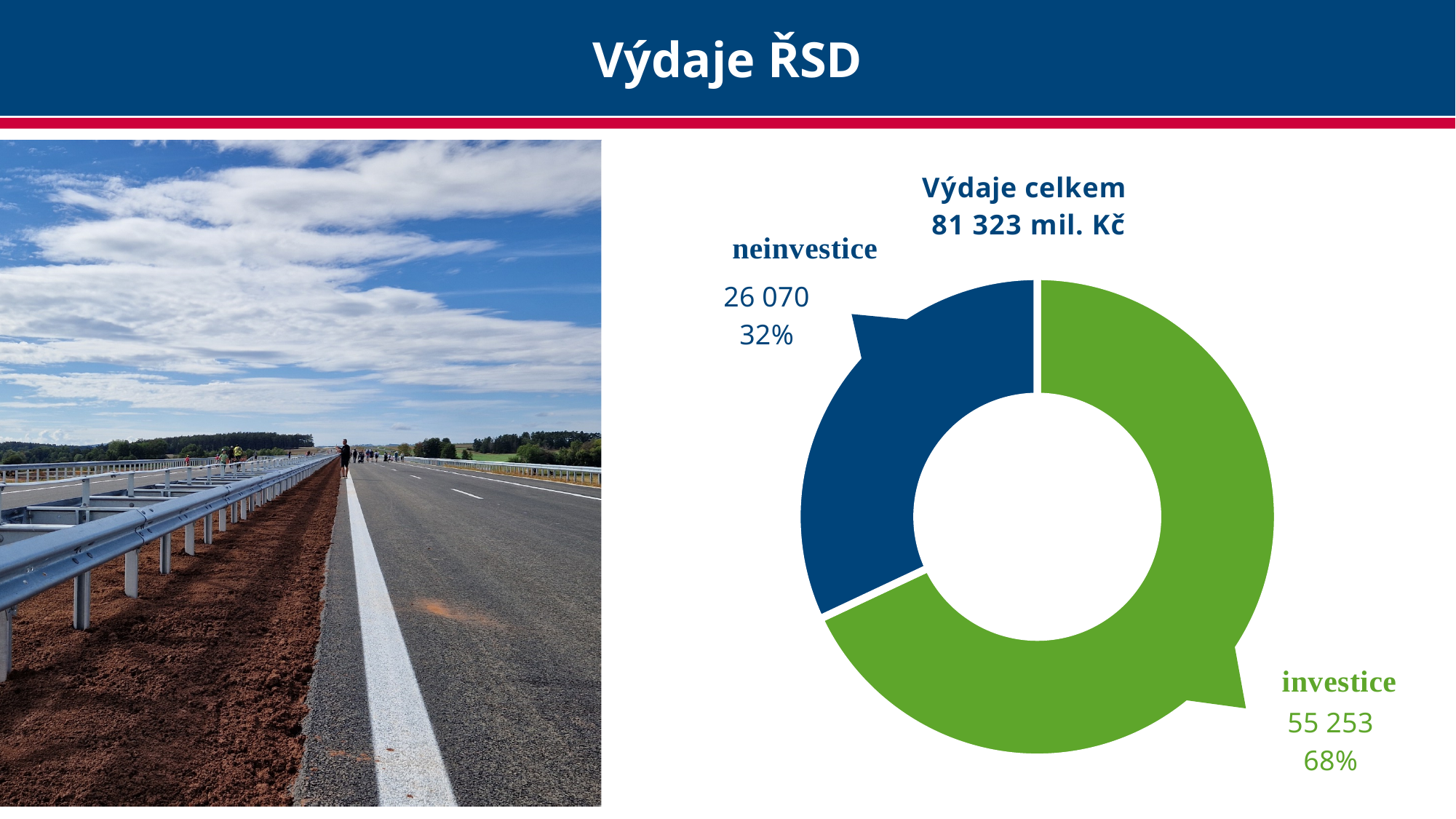
What total expenditure is stated above the chart? 81 323 mil. Kč What is the value for neinvestice? 26 070 What share of the chart does neinvestice represent? 32% What is the difference between the values for investice and neinvestice? 29 183 Which category has the smallest slice? neinvestice Which is larger, investice or neinvestice? investice Which category has the largest slice? investice What is the value for investice? 55 253 How many categories does the chart show? 2 What share of the chart does investice represent? 68% What kind of chart is shown on the slide? Doughnut (pie) chart What colour is the investice slice? Green